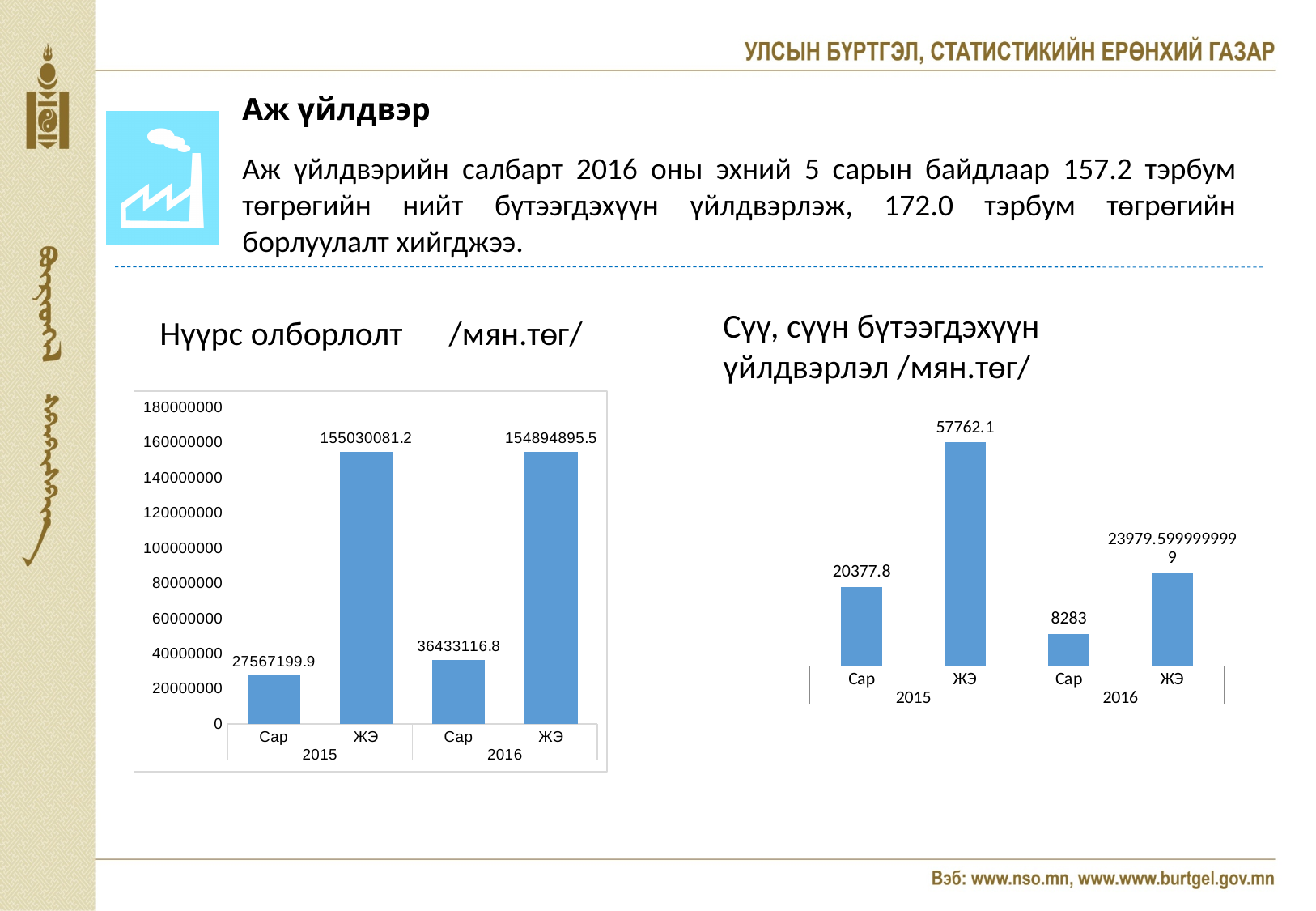
In the 'Нүүрс олборлолт' chart, is the value for Сар 2016 greater or less than 40000000? less In the 'Нүүрс олборлолт' chart, what is the value for ЖЭ 2016? 154894895.5 In the 'Нүүрс олборлолт' chart, which bar is the lowest? Сар 2015 How many bars are plotted in the 'Нүүрс олборлолт' chart? 4 In the 'Сүү, сүүн бүтээгдэхүүн үйлдвэрлэл' chart, which is larger: Сар 2015 or Сар 2016? Сар 2015 In the 'Нүүрс олборлолт' chart, which bar is the highest? ЖЭ 2015 In the 'Сүү, сүүн бүтээгдэхүүн үйлдвэрлэл' chart, what is the value for Сар 2016? 8283 In the 'Сүү, сүүн бүтээгдэхүүн үйлдвэрлэл' chart, what is the difference between ЖЭ 2015 and Сар 2015? 37384.3 In the 'Нүүрс олборлолт' chart, what is the value for Сар 2015? 27567199.9 In the 'Нүүрс олборлолт' chart, what is the difference between Сар 2016 and Сар 2015? 8865916.9 In the 'Сүү, сүүн бүтээгдэхүүн үйлдвэрлэл' chart, what is the value for ЖЭ 2015? 57762.1 What type of chart is the 'Сүү, сүүн бүтээгдэхүүн үйлдвэрлэл' chart? bar chart